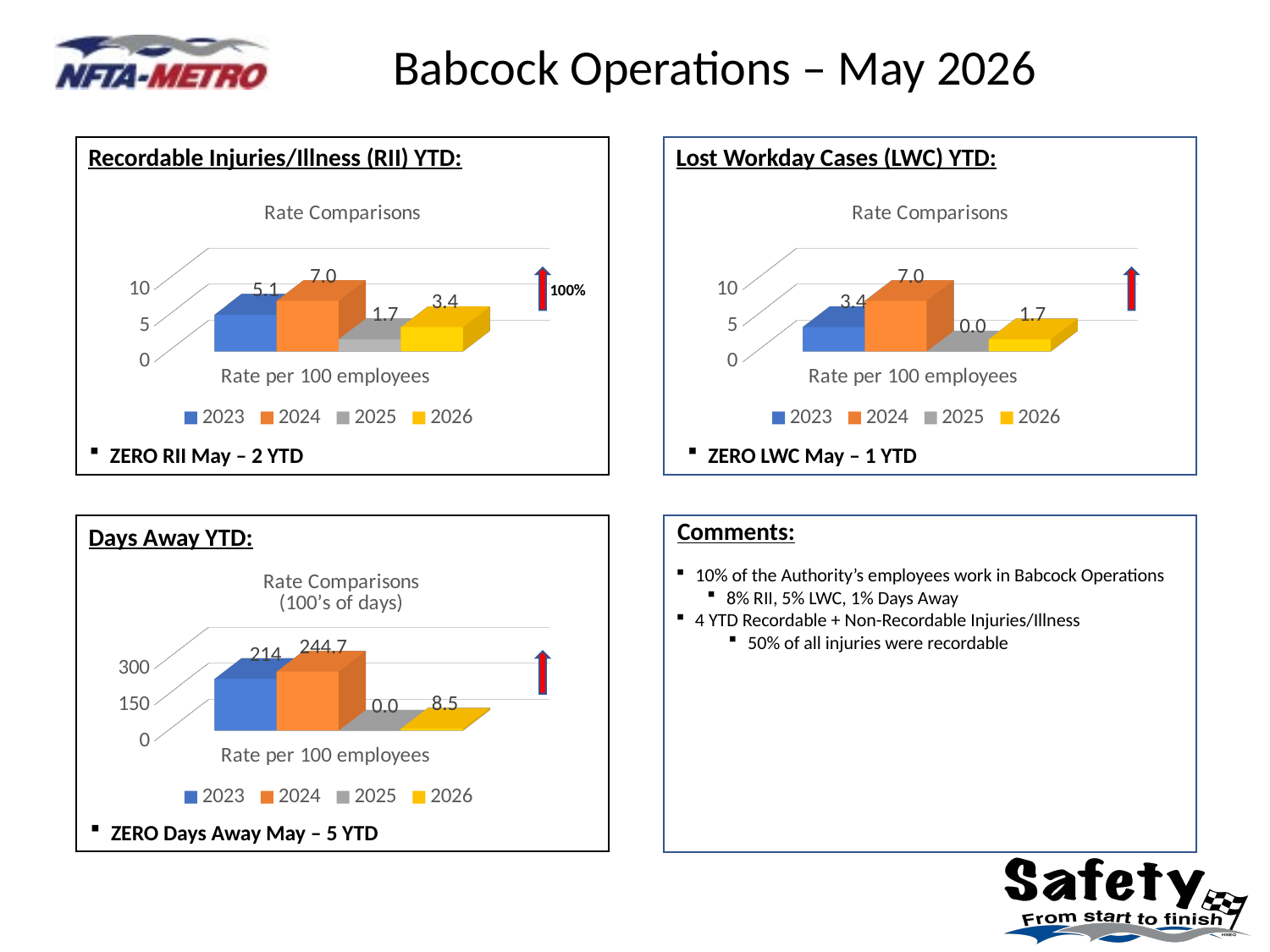
In the Days Away YTD chart, what is the value for 2024? 244.7 In the Recordable Injuries/Illness (RII) YTD chart, what is the value for 2024? 7.0 In the Lost Workday Cases (LWC) YTD chart, is the value for 2023 larger or smaller than the value for 2026? larger In the Lost Workday Cases (LWC) YTD chart, what is the value for 2025? 0.0 In the Days Away YTD chart, what is the difference between the 2024 and 2023 values? 30.7 What is the x-axis category label shown in the Lost Workday Cases (LWC) YTD chart? Rate per 100 employees In the Recordable Injuries/Illness (RII) YTD chart, which year has the lowest rate? 2025 What type of chart is used in the Recordable Injuries/Illness (RII) YTD box? Bar chart In the Days Away YTD chart, is the value for 2023 greater or less than 150? greater How many series does the legend of the Days Away YTD chart list? 4 In the Recordable Injuries/Illness (RII) YTD chart, what is the difference between the 2023 and 2026 values? 1.7 In the Lost Workday Cases (LWC) YTD chart, which year has the highest rate? 2024